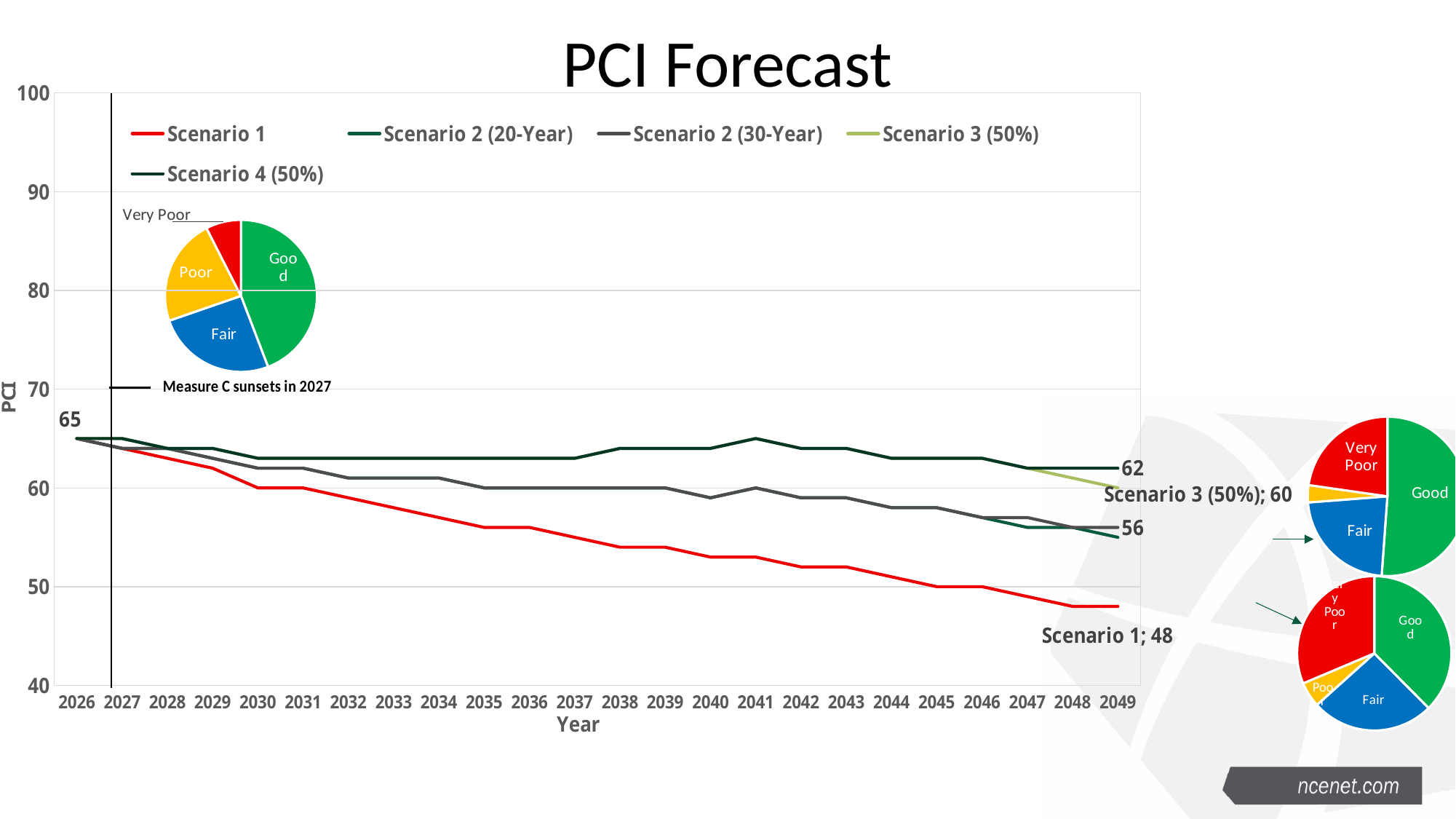
In the PCI Forecast line chart, what value is labeled for Scenario 3 (50%) at the end of the forecast? 60 In the PCI Forecast line chart, what value is labeled for Scenario 1 at the end of the forecast? 48 In the PCI Forecast line chart, is the Scenario 1 value in 2040 greater or less than 60? less In the PCI Forecast line chart, what value is labeled at the end of the Scenario 2 (30-Year) line in 2049? 56 In the PCI Forecast line chart, by how much does Scenario 1 fall from its 2026 value of 65 to its labeled end value? 17 In the PCI Forecast line chart, what is the difference between the labeled end values of Scenario 3 (50%) and Scenario 1? 12 In the PCI Forecast line chart, which ends higher in 2049: Scenario 1 or Scenario 3 (50%)? Scenario 3 (50%) In the PCI Forecast line chart, what is the PCI value labeled at the start of the lines in 2026? 65 In the PCI Forecast line chart, does the Scenario 1 line rise or fall from 2026 to 2049? fall What kind of chart is the main PCI Forecast chart? line chart How many slices does the pie chart in the upper left of the slide have? 4 How many series does the legend of the PCI Forecast line chart list? 5